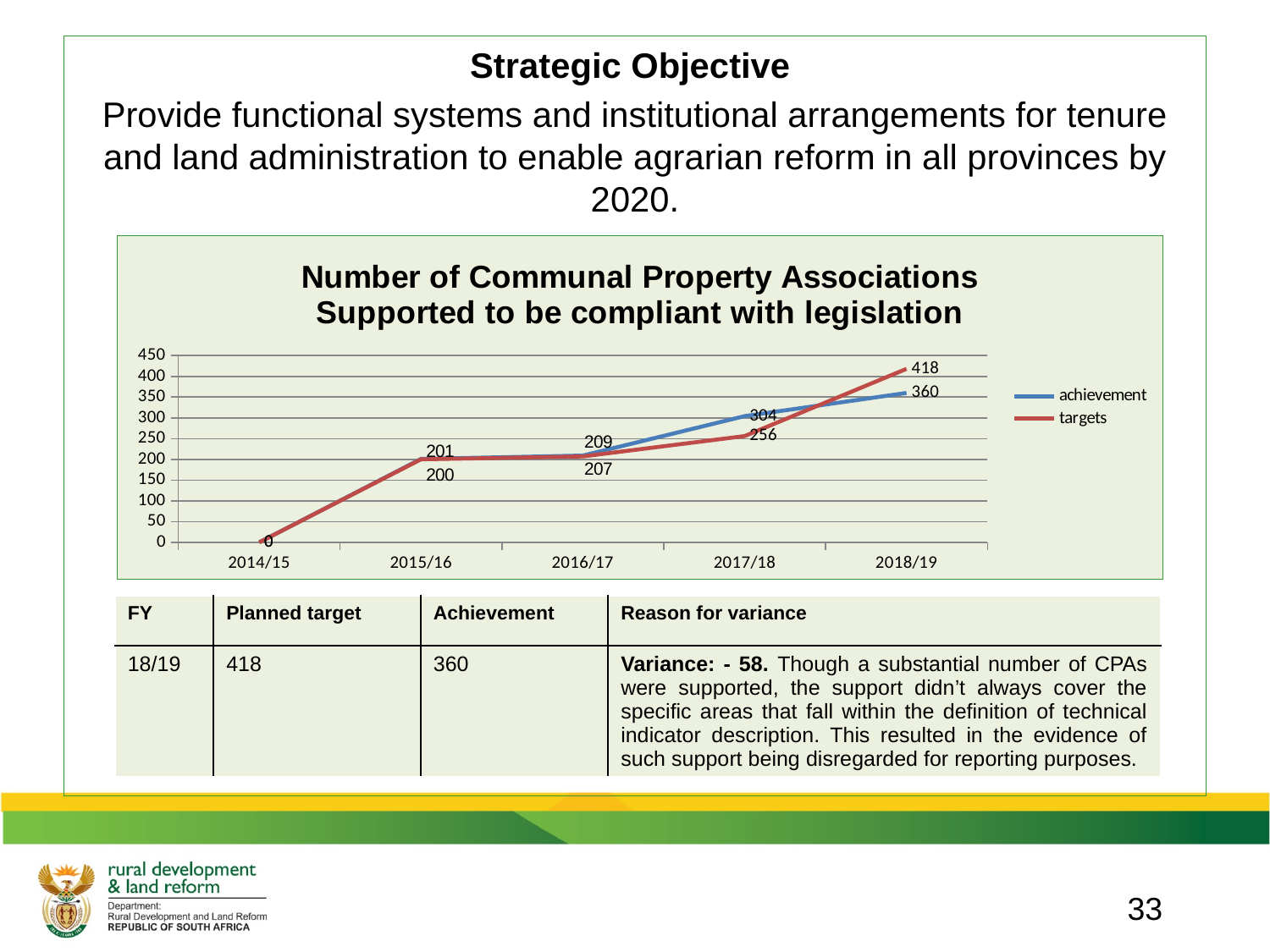
What is the targets value for 2018/19? 418 By how much does the achievement exceed the target in 2017/18? 48 What is the achievement value for 2017/18? 304 How many financial years are shown on the x axis of the chart? 5 In which financial year is the achievement value highest? 2018/19 What is the achievement value for 2018/19? 360 Do the targets values rise or fall from 2014/15 to 2018/19? rise In 2017/18, which is larger: achievement or targets? achievement By how much does the target exceed the achievement in 2018/19? 58 How many series does the chart legend list? 2 What type of chart is shown on the slide? Line chart What is the targets value for 2017/18? 256